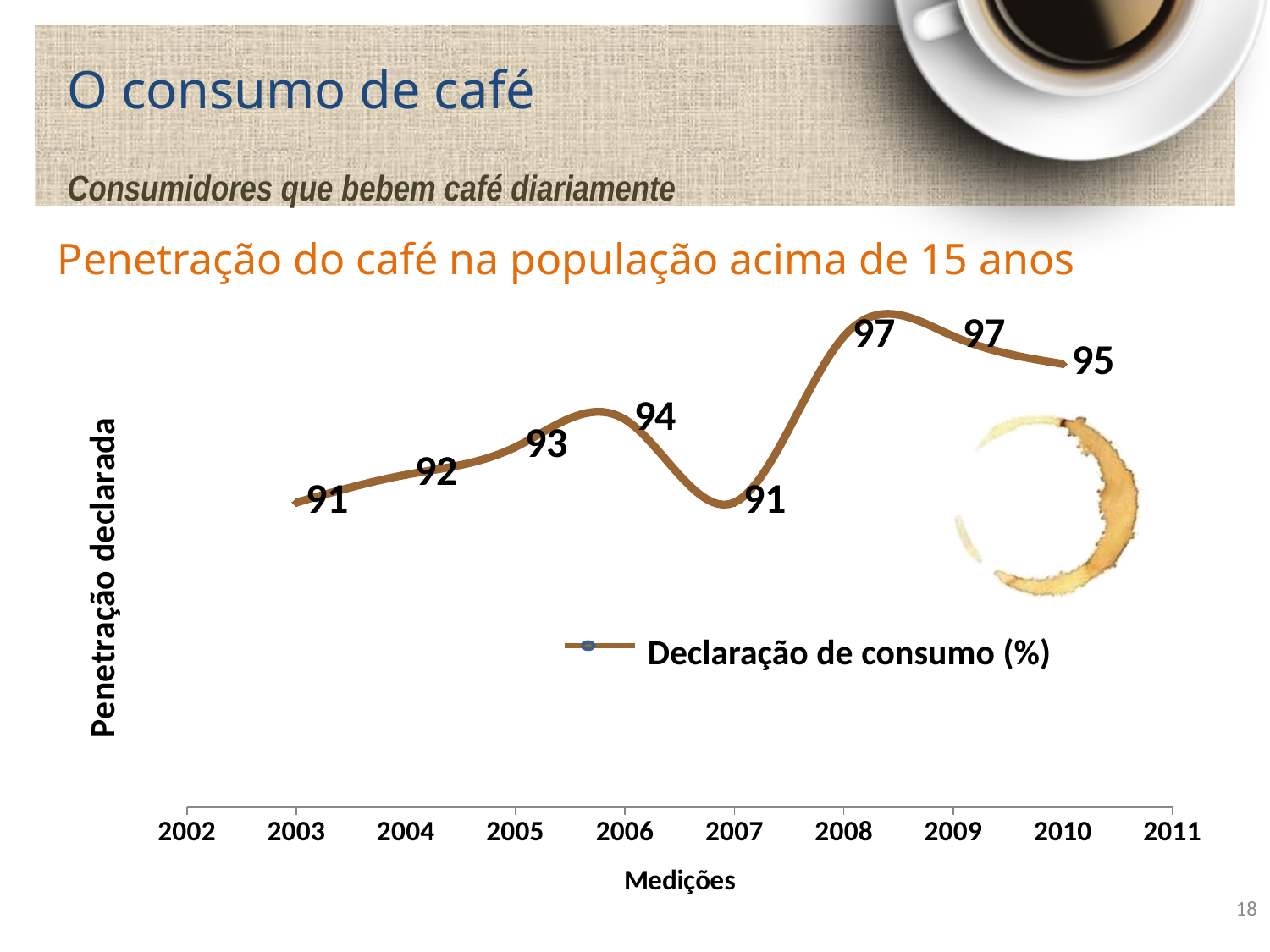
What is the value for 2010? 95 What is the lowest value plotted on the line? 91 What is the value for 2003? 91 How many series does the legend list? 1 What is the highest value plotted on the line? 97 What kind of chart is shown on the slide? Line chart What is the series name shown in the legend? Declaração de consumo (%) How many data points are plotted on the line? 8 What is the value for 2006? 94 What is the difference between the values for 2008 and 2007? 6 Which year has the larger value, 2006 or 2010? 2010 What is the value for 2008? 97